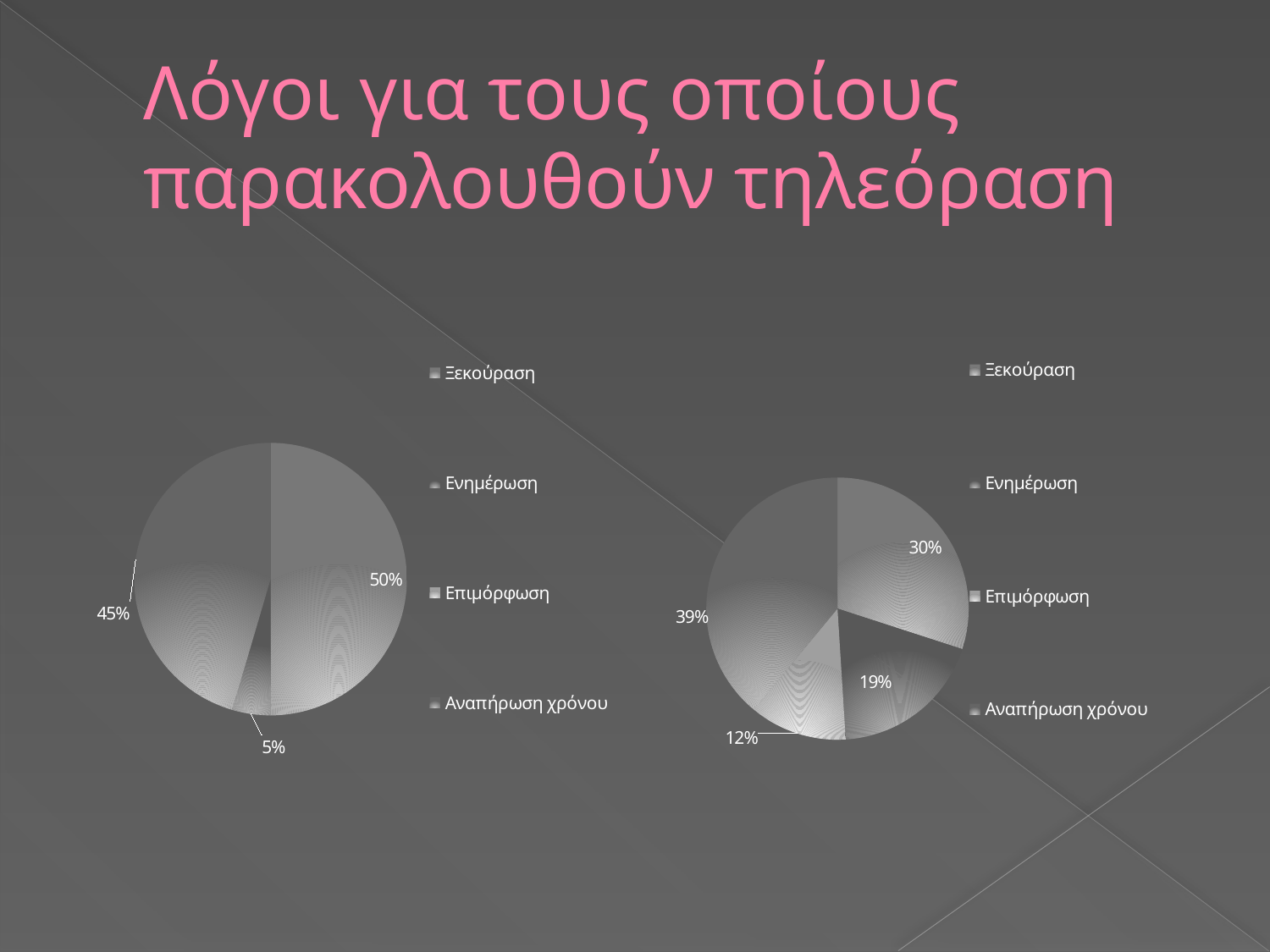
How many entries does the legend of the right pie chart list? 4 How many labelled slices does the right pie chart have? 4 What is the first entry in the legend of the left pie chart? Ξεκούραση In the right pie chart, what is the value of the largest slice? 39% In the right pie chart, which is larger: the slice labelled 19% or the slice labelled 12%? 19% In the right pie chart, what is the difference between the 30% slice and the 19% slice? 11 percentage points What kind of chart is the chart on the left of the slide? pie chart In the left pie chart, what is the value of the largest slice? 50% In the right pie chart, what is the value of the smallest slice? 12% In the left pie chart, what is the difference between the 50% slice and the 45% slice? 5 percentage points In the right pie chart, what do the 30% and 19% slices add up to? 49% In the left pie chart, what is the value of the smallest labelled slice? 5%